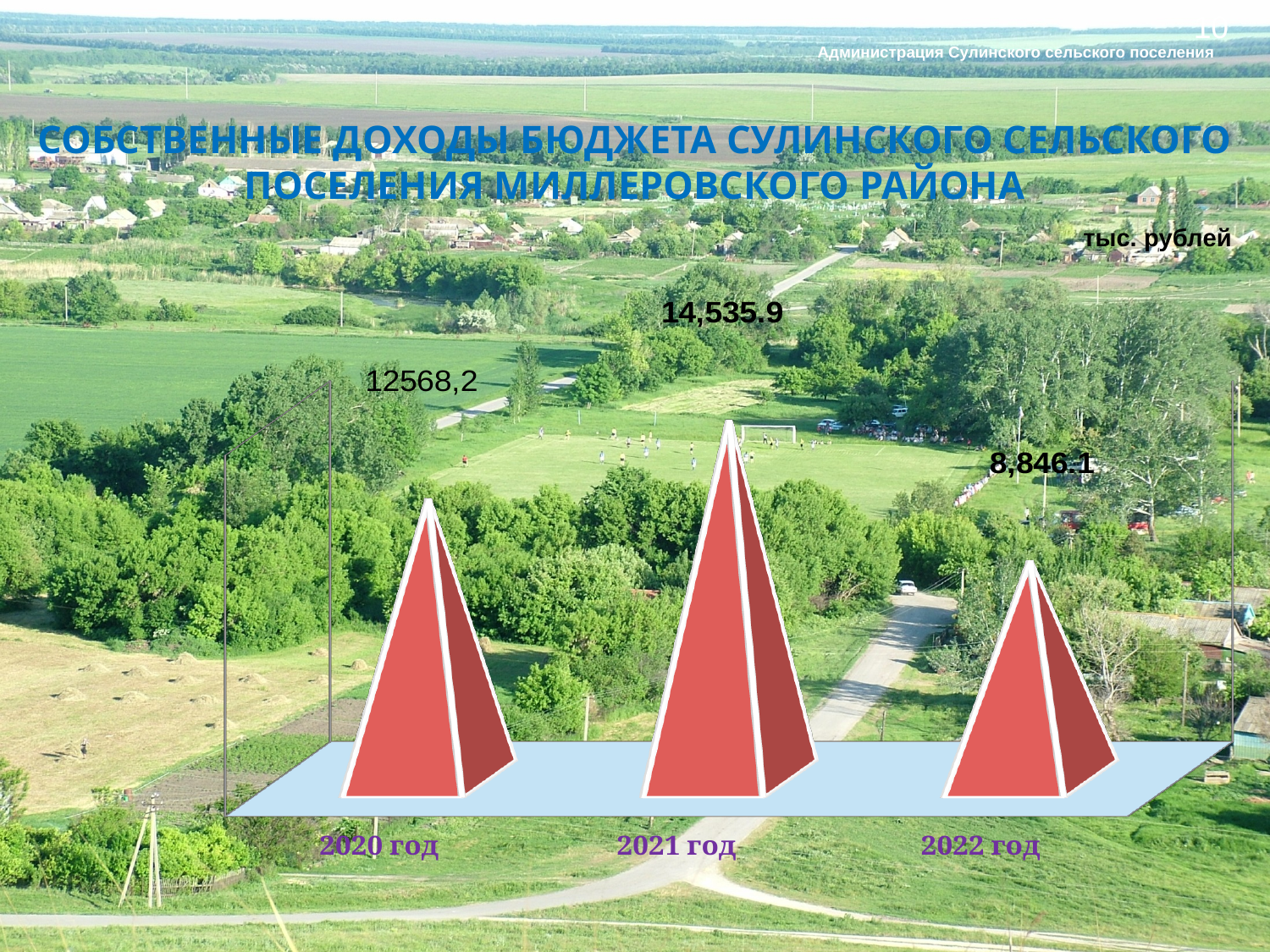
Which year has the highest value? 2021 год Which is larger, the value for 2021 год or the value for 2020 год? 2021 год What is the value for 2021 год? 14,535.9 What is the difference between the values for 2021 год and 2022 год? 5,689.8 In what units are the chart values given? тыс. рублей Do the values rise or fall from 2021 год to 2022 год? Fall Which is larger, the value for 2020 год or the value for 2022 год? 2020 год Which year has the lowest value? 2022 год What kind of chart is shown on the slide? Bar chart What is the value for 2020 год? 12568,2 How many years are shown on the chart? 3 What is the value for 2022 год? 8,846.1